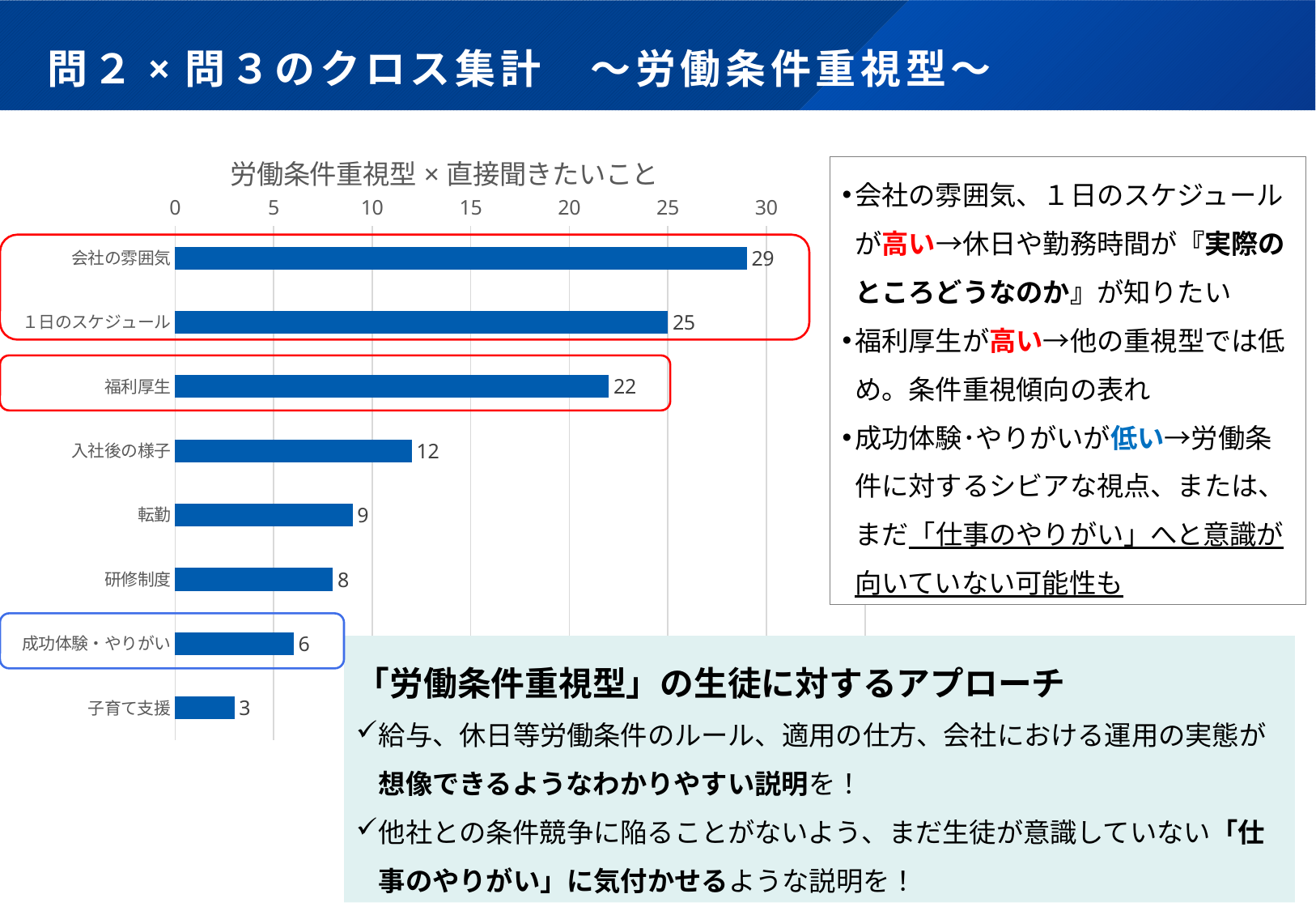
Which category has the highest value? 会社の雰囲気 Which category has the lowest value? 子育て支援 What is the difference between the values for 成功体験・やりがい and 子育て支援? 3 How many categories are shown in the chart? 8 Which is larger, the value for 入社後の様子 or the value for 研修制度? 入社後の様子 What is the value for 転勤? 9 What is the difference between the values for 会社の雰囲気 and １日のスケジュール? 4 What is the value for 会社の雰囲気? 29 Is the value for 福利厚生 greater or less than 20? greater What is the title of the chart? 労働条件重視型 × 直接聞きたいこと What kind of chart is shown on the slide? bar chart What is the value for 福利厚生? 22